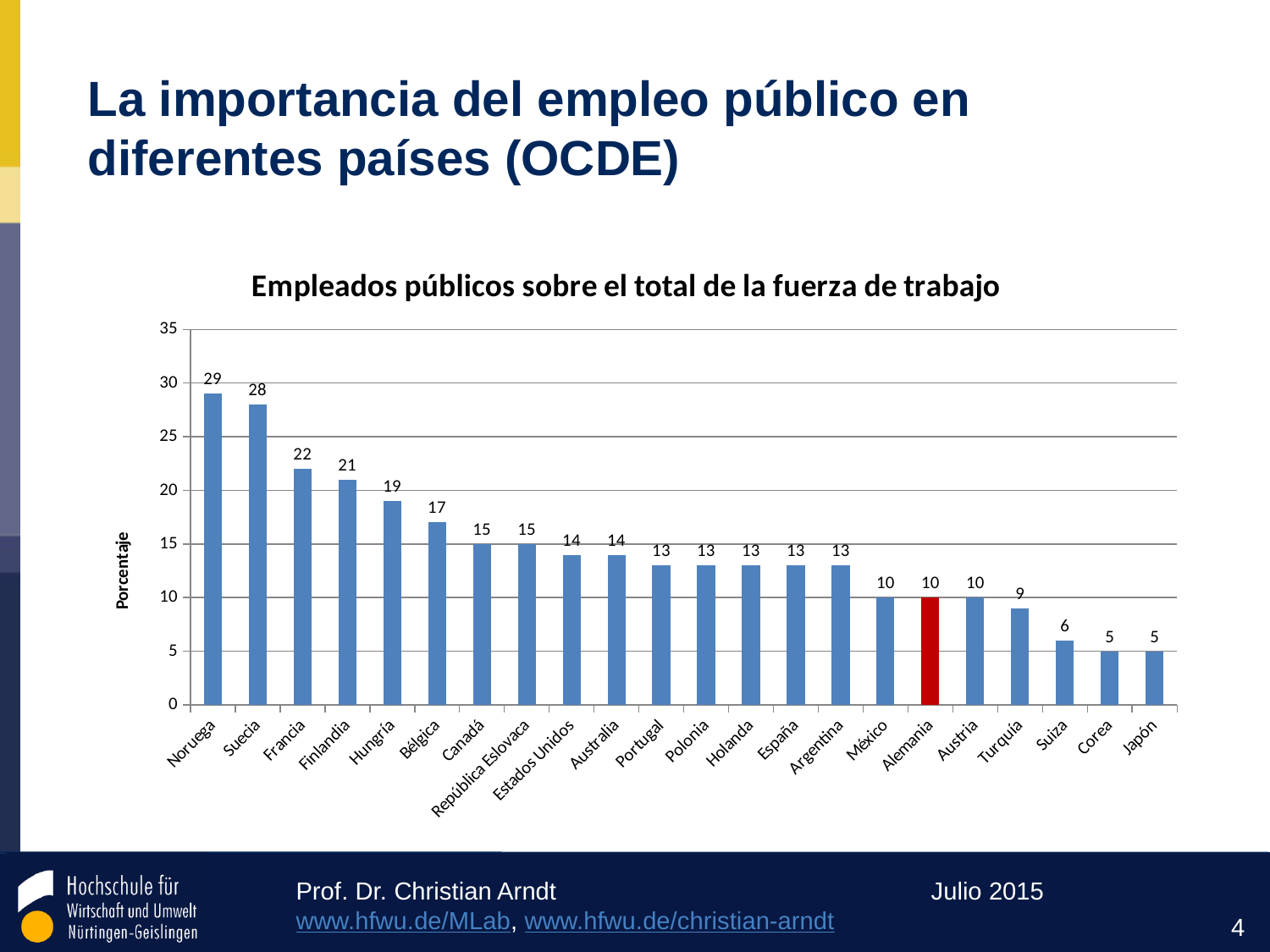
Do the values rise or fall from left to right along the x axis? fall Which country has the highest value? Noruega What is the difference between the values for Noruega and Suecia? 1 How many countries are shown in the chart? 22 What is the value for Alemania? 10 What is the difference between the values for Francia and Alemania? 12 Which country's bar is coloured red? Alemania What is the value for Francia? 22 Which is larger, the value for Hungría or the value for Bélgica? Hungría What kind of chart is shown on the slide? bar chart Is the value for Turquía greater or less than 10? less What is the value for Japón? 5